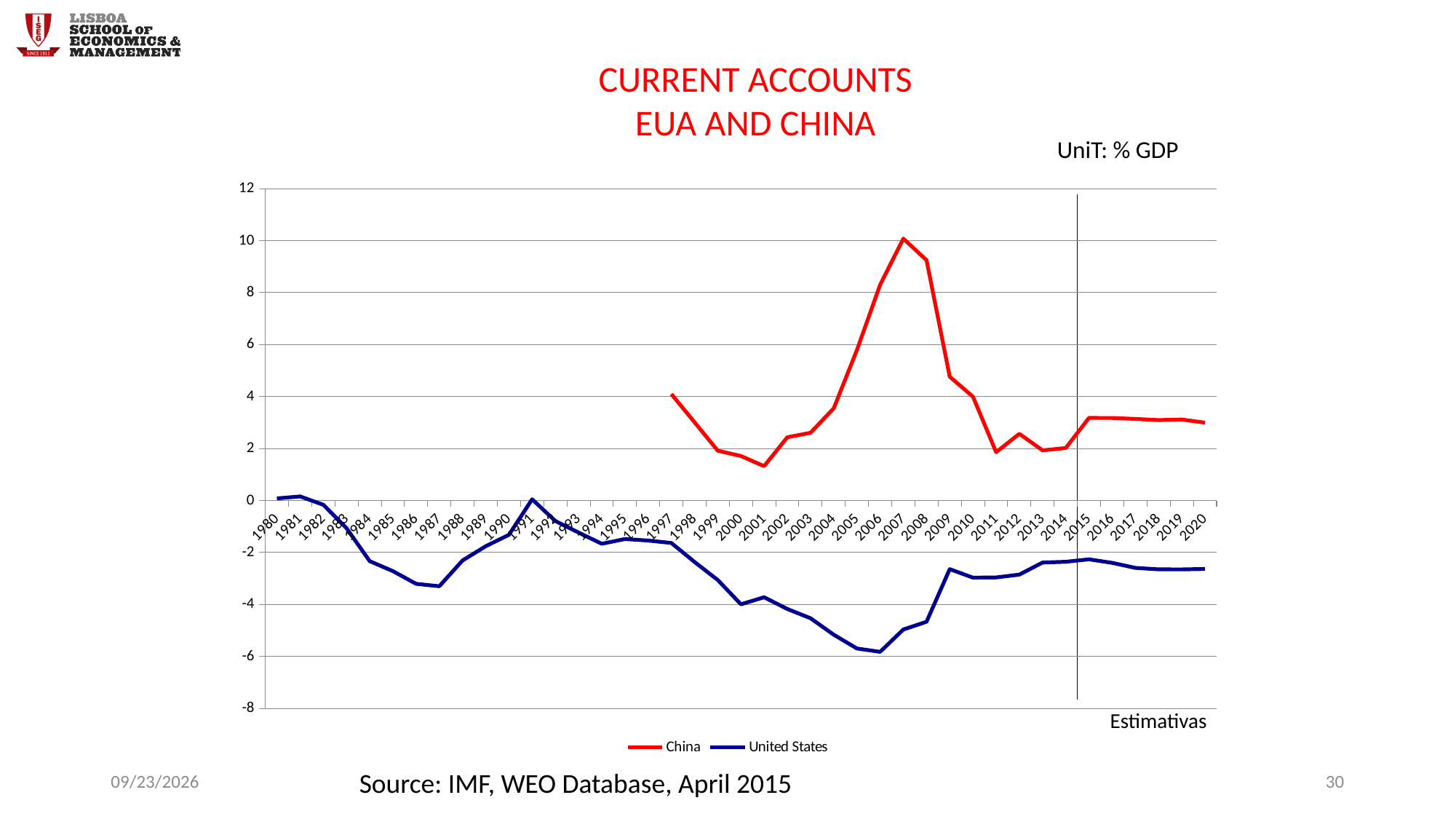
How many series does the legend list? 2 What unit is stated for the values in the chart? % GDP How many years are shown on the x axis? 41 Is the value for China in 2007 greater or less than 8? greater Which two series are shown in the legend? China and United States Is the value for China in 2001 greater or less than 2? less Is the value for the United States in 1986 greater or less than -2? less What kind of chart is shown on the slide? line chart In which year does the China series reach its highest value? 2007 Does the China series rise or fall between 2007 and 2011? fall Which is larger for China: the value in 2007 or the value in 2011? 2007